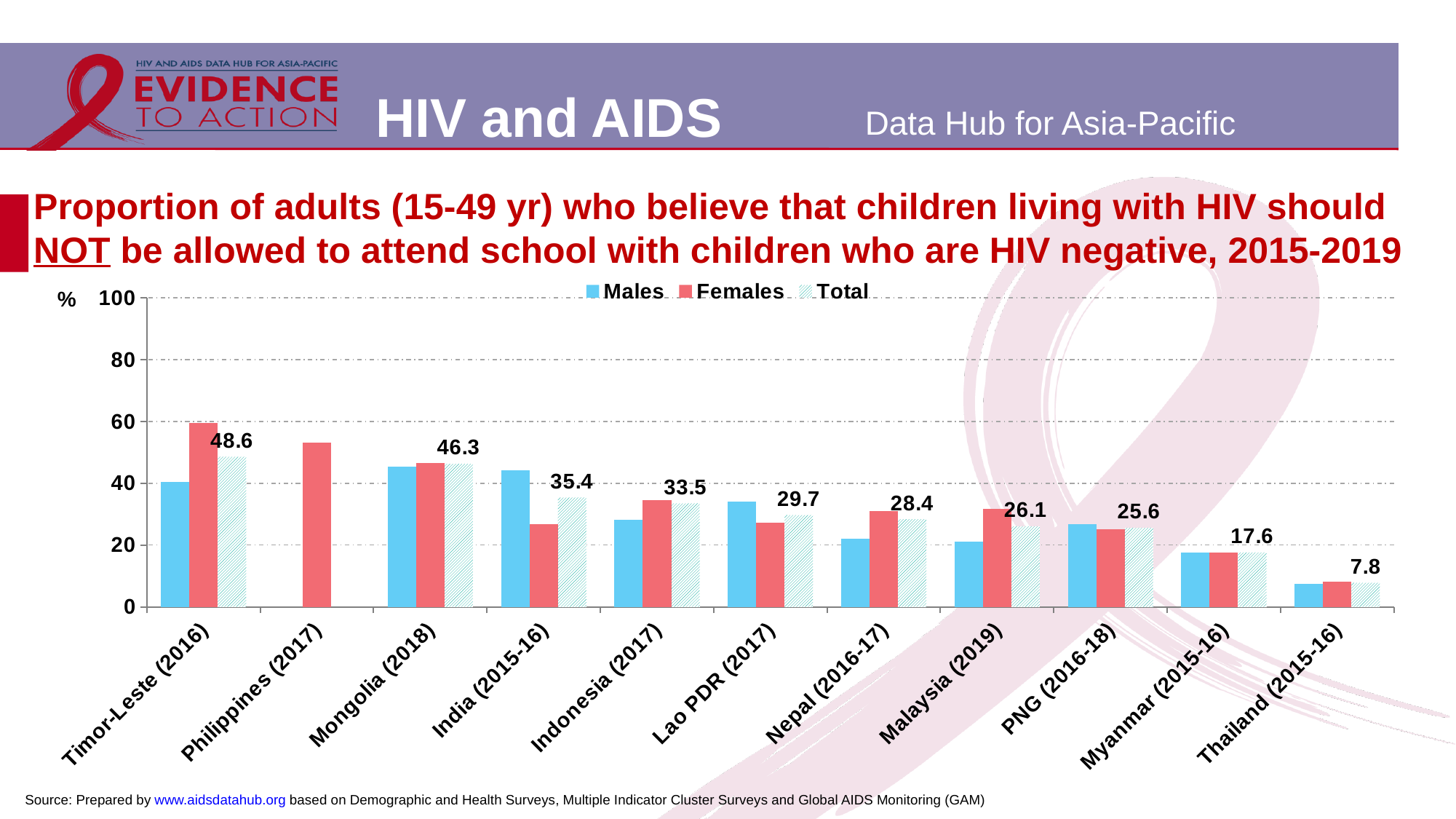
How many series does the legend list? 3 What is the Total value for Thailand (2015-16)? 7.8 What is the Total value for Timor-Leste (2016)? 48.6 Do the Total values rise or fall from left to right across the countries? fall Which country has the highest Total value? Timor-Leste (2016) Is the Females value for Philippines (2017) greater or less than 40? greater Which country has the lowest Total value? Thailand (2015-16) Which has a larger Total value, Indonesia (2017) or Lao PDR (2017)? Indonesia (2017) Is the Males value for Nepal (2016-17) greater or less than 40? less What is the difference between the Total values for Mongolia (2018) and India (2015-16)? 10.9 How many countries are shown on the x axis? 11 What is the Total value for Indonesia (2017)? 33.5